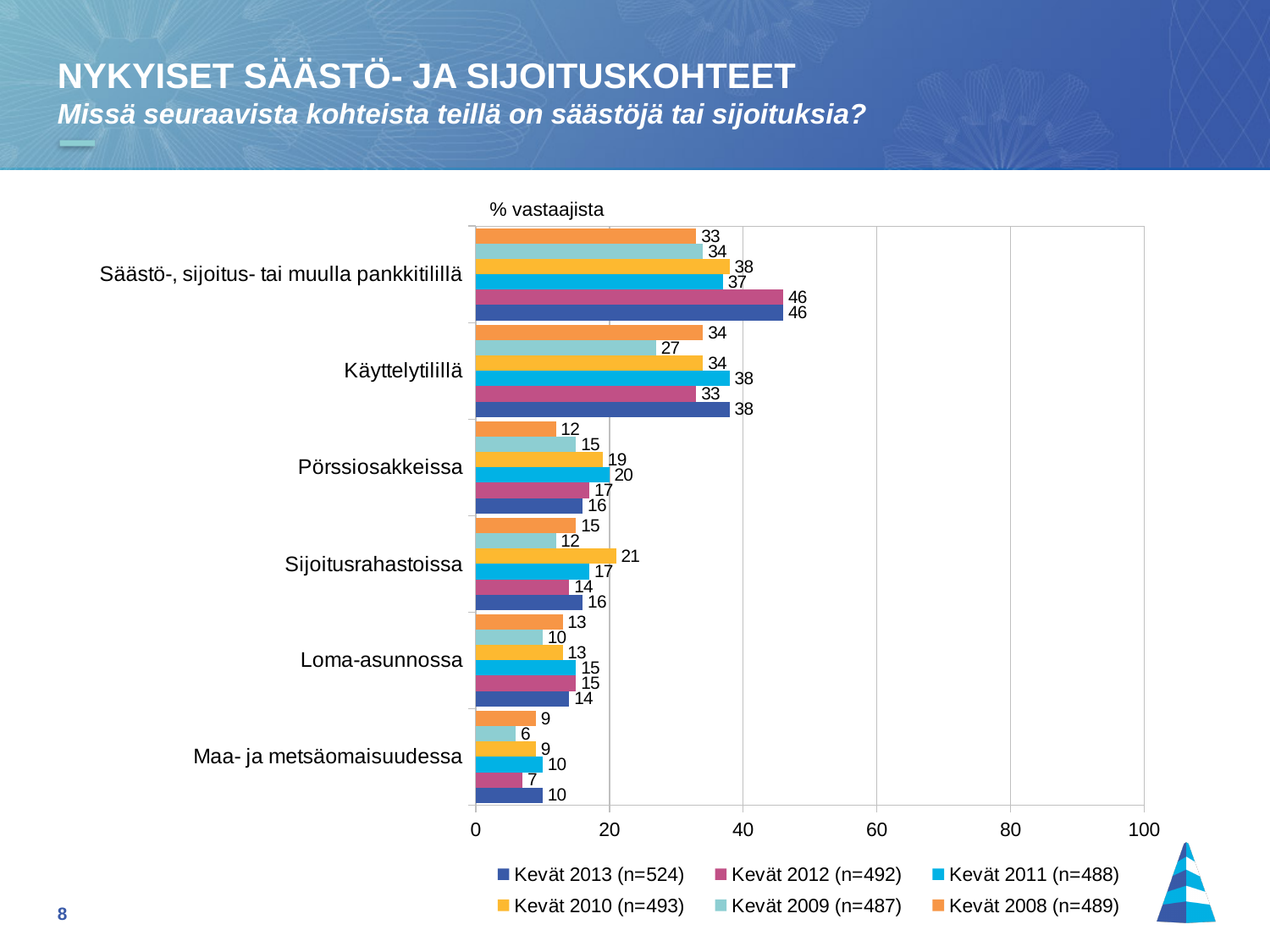
What is the value for Kevät 2009 (n=487) in the category Käyttelytilillä? 27 What is the value for Kevät 2013 (n=524) in the category Säästö-, sijoitus- tai muulla pankkitilillä? 46 What is the difference between the Kevät 2011 (n=488) and Kevät 2008 (n=489) values for Pörssiosakkeissa? 8 Which category has the lowest value for Kevät 2009 (n=487)? Maa- ja metsäomaisuudessa What is the value for Kevät 2010 (n=493) in the category Sijoitusrahastoissa? 21 Which category has the highest value for Kevät 2012 (n=492)? Säästö-, sijoitus- tai muulla pankkitilillä How many categories are shown on the chart? 6 For Loma-asunnossa, which is larger: the value for Kevät 2011 (n=488) or the value for Kevät 2009 (n=487)? Kevät 2011 (n=488) What is the value for Kevät 2012 (n=492) in the category Maa- ja metsäomaisuudessa? 7 What is the label on the horizontal axis of the chart? % vastaajista How many series does the legend list? 6 What type of chart is shown on the slide? bar chart